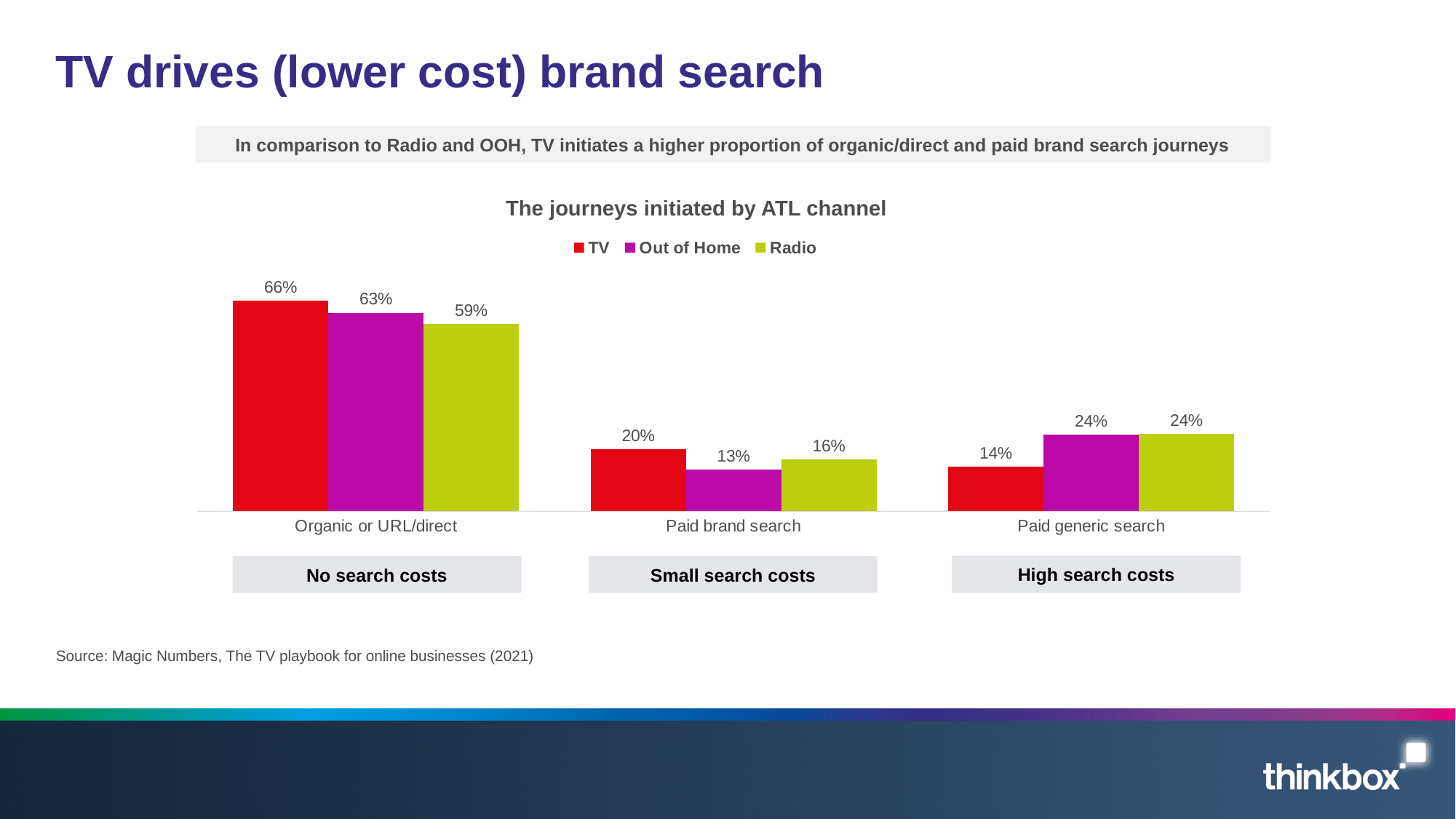
What is the difference between the TV and Out of Home values for Paid brand search? 7% What is the TV value for Organic or URL/direct? 66% Which channel has the highest value for Organic or URL/direct? TV What kind of chart is shown? Bar chart What is the Radio value for Paid generic search? 24% What is the difference between the TV and Radio values for Organic or URL/direct? 7% What is the Out of Home value for Paid brand search? 13% Which channel has the lowest value for Paid generic search? TV How many categories are shown on the x axis? 3 What is the title of the chart? The journeys initiated by ATL channel How many series does the legend list? 3 Which is larger for Paid brand search: Radio or Out of Home? Radio